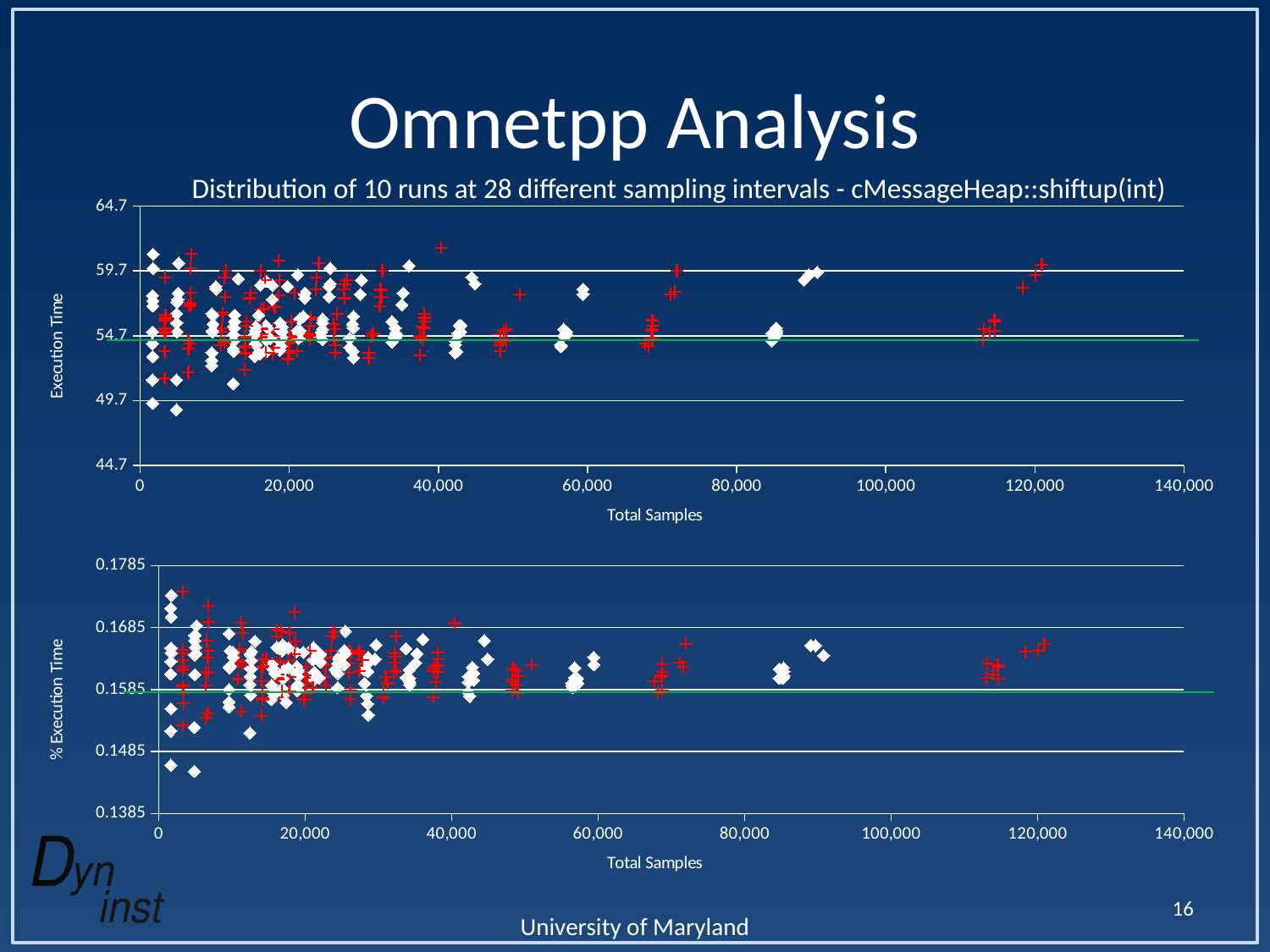
In the top chart, are the points plotted near 120,000 total samples greater or less than 64.7 on the Execution Time axis? less In the bottom chart, are the points plotted near 120,000 total samples greater or less than 0.1485 on the % Execution Time axis? greater In the bottom chart, are the points plotted near 60,000 total samples greater or less than 0.1685 on the % Execution Time axis? less What is the title of the top chart? Distribution of 10 runs at 28 different sampling intervals - cMessageHeap::shiftup(int) What kind of chart is the top chart on the slide? Scatter chart What is the y-axis label of the bottom chart? % Execution Time What kind of chart is the bottom chart on the slide? Scatter chart